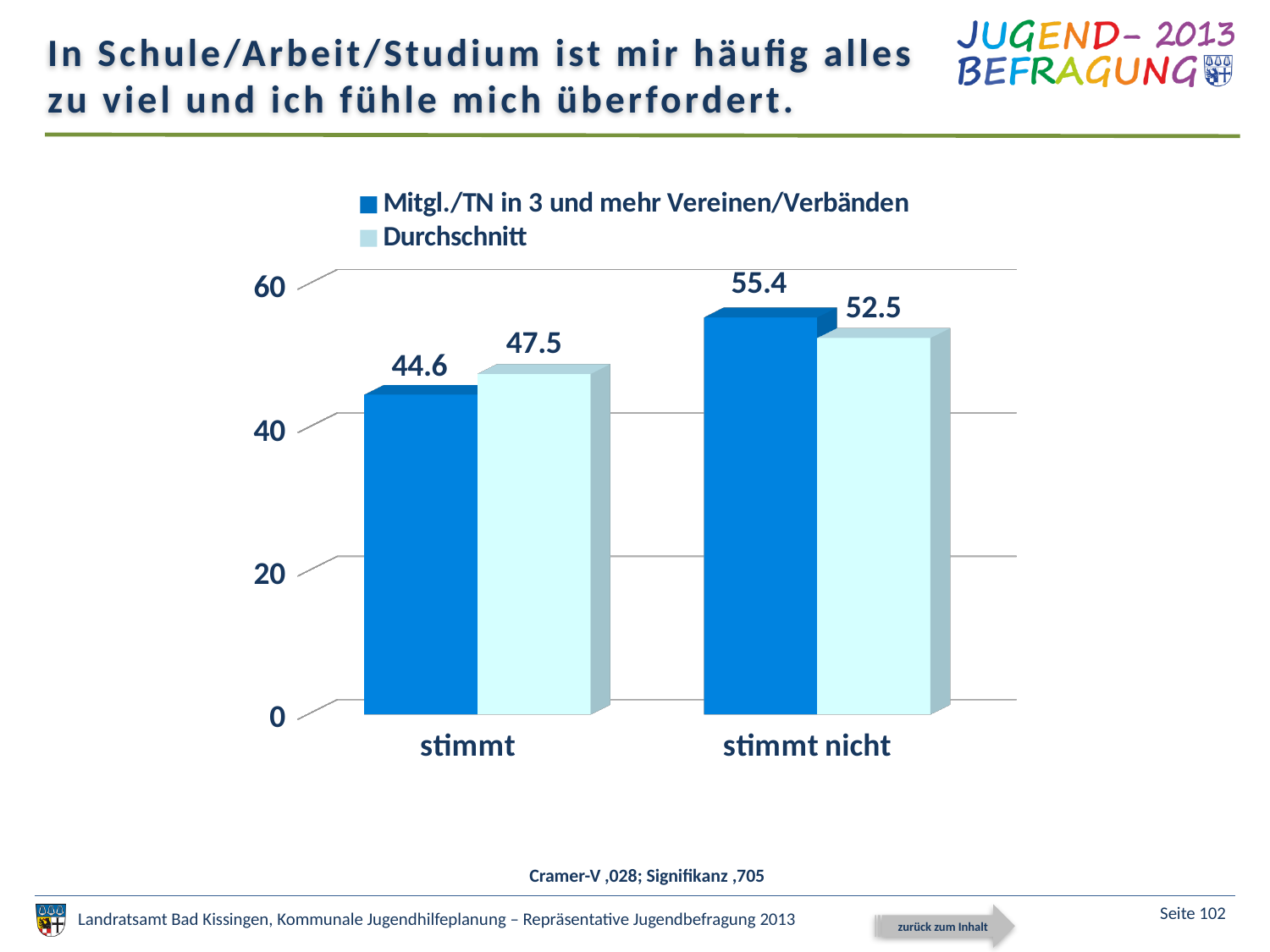
What is the difference between the "Durchschnitt" and "Mitgl./TN in 3 und mehr Vereinen/Verbänden" values in the "stimmt" category? 2.9 What is the value for "Mitgl./TN in 3 und mehr Vereinen/Verbänden" in the "stimmt" category? 44.6 What is the value for "Mitgl./TN in 3 und mehr Vereinen/Verbänden" in the "stimmt nicht" category? 55.4 What is the value for "Durchschnitt" in the "stimmt" category? 47.5 How many categories are shown on the x axis? 2 Which category has the lowest value for "Durchschnitt"? stimmt In the "stimmt nicht" category, which series has the larger value? Mitgl./TN in 3 und mehr Vereinen/Verbänden What kind of chart is shown on the slide? bar chart What is the value for "Durchschnitt" in the "stimmt nicht" category? 52.5 Which category has the highest value for "Mitgl./TN in 3 und mehr Vereinen/Verbänden"? stimmt nicht What is the difference between the "Mitgl./TN in 3 und mehr Vereinen/Verbänden" and "Durchschnitt" values in the "stimmt nicht" category? 2.9 How many series does the legend list? 2